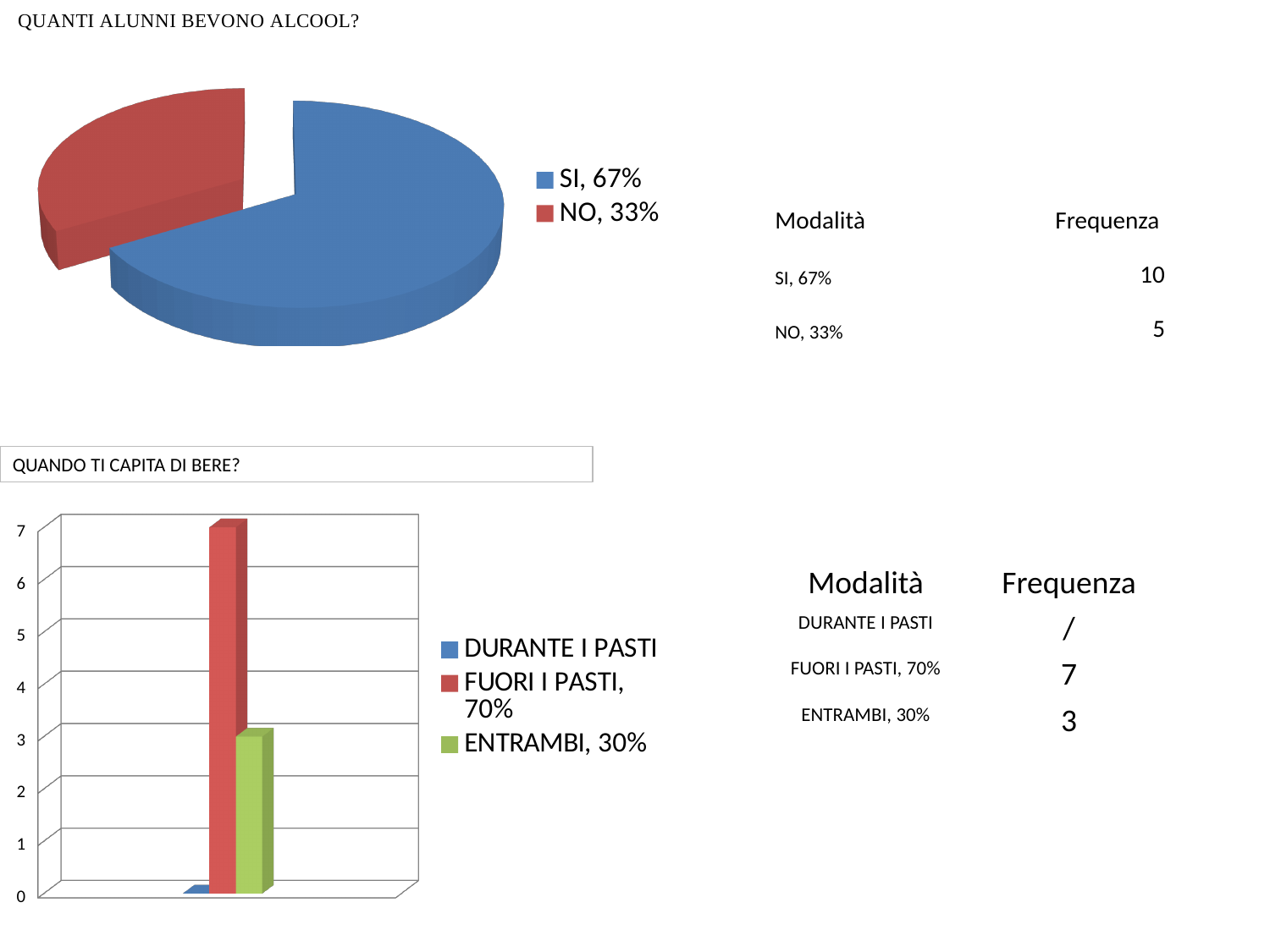
In the pie chart 'QUANTI ALUNNI BEVONO ALCOOL?', which slice is the largest? SI In the bar chart 'QUANDO TI CAPITA DI BERE?', what value does the bar for FUORI I PASTI reach? 7 In the pie chart 'QUANTI ALUNNI BEVONO ALCOOL?', what percentage is shown for SI? 67% In the bar chart 'QUANDO TI CAPITA DI BERE?', which category has the tallest bar? FUORI I PASTI In the bar chart 'QUANDO TI CAPITA DI BERE?', how many entries does the legend list? 3 In the bar chart 'QUANDO TI CAPITA DI BERE?', is the bar for ENTRAMBI greater or less than 5? less What type of chart is the bottom chart 'QUANDO TI CAPITA DI BERE?'? Bar chart What type of chart is the top chart 'QUANTI ALUNNI BEVONO ALCOOL?'? Pie chart In the pie chart 'QUANTI ALUNNI BEVONO ALCOOL?', how many slices does the pie have? 2 In the bar chart 'QUANDO TI CAPITA DI BERE?', what value does the bar for ENTRAMBI reach? 3 In the pie chart 'QUANTI ALUNNI BEVONO ALCOOL?', what percentage is shown for NO? 33% In the pie chart 'QUANTI ALUNNI BEVONO ALCOOL?', what colour is the SI slice? Blue